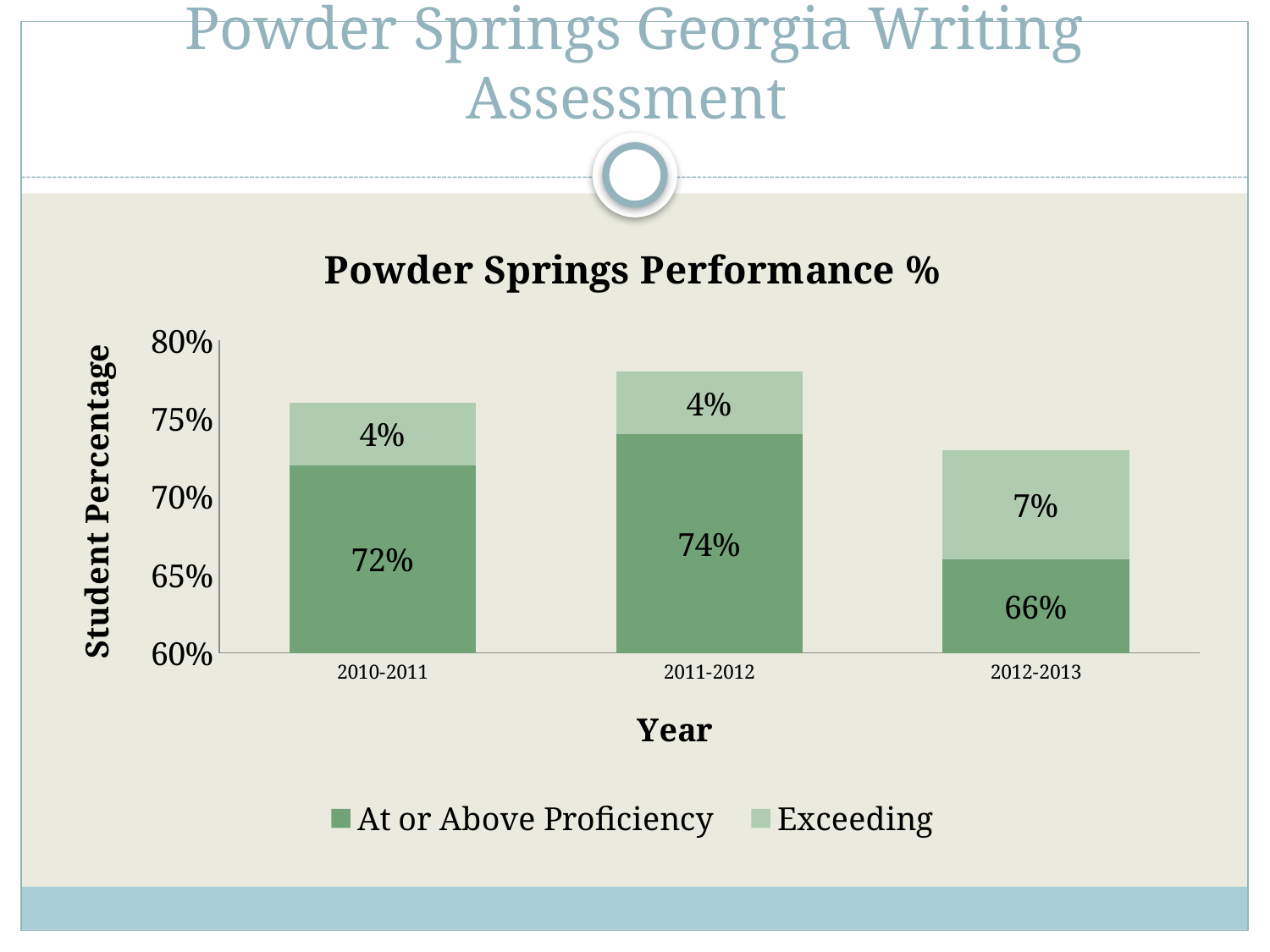
What is the Exceeding value for 2012-2013? 7% What is the title of the chart? Powder Springs Performance % How many years are shown on the x axis? 3 What is the At or Above Proficiency value for 2010-2011? 72% What type of chart is shown on the slide? Stacked bar chart Which year has the lowest At or Above Proficiency value? 2012-2013 What is the At or Above Proficiency value for 2011-2012? 74% What is the difference between the At or Above Proficiency values for 2011-2012 and 2012-2013? 8% How many series does the legend list? 2 Which year has the highest Exceeding value? 2012-2013 What is the total of the stacked bar for 2011-2012? 78% Is the At or Above Proficiency value for 2010-2011 larger or smaller than the value for 2011-2012? Smaller